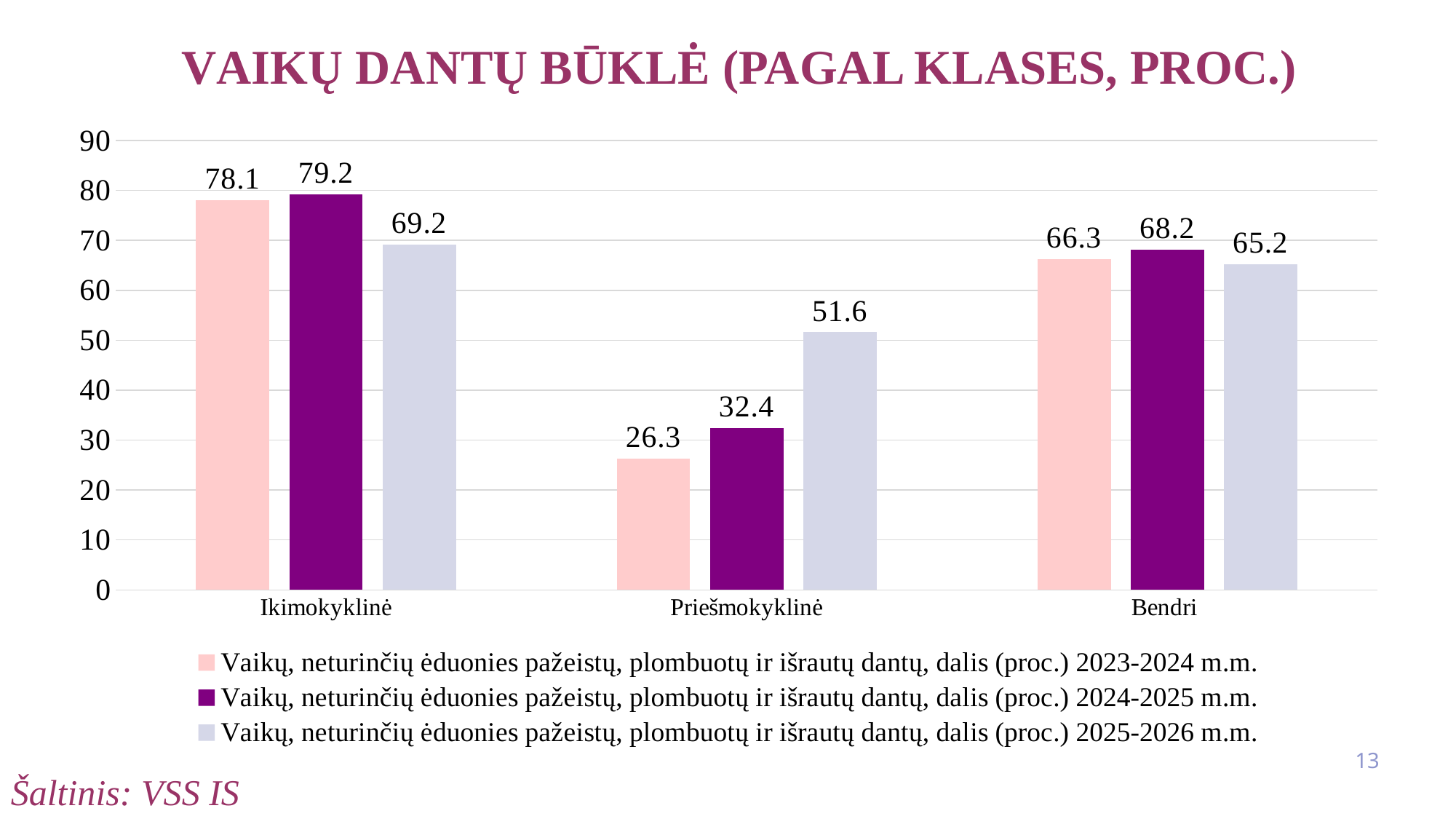
What is the value for Priešmokyklinė in the 2025-2026 m.m. series? 51.6 What is the value for Ikimokyklinė in the 2024-2025 m.m. series? 79.2 What is the difference between the 2025-2026 m.m. and 2024-2025 m.m. values for Priešmokyklinė? 19.2 Which category has the highest value in the 2025-2026 m.m. series? Ikimokyklinė What is the value for Bendri in the 2023-2024 m.m. series? 66.3 What is the title of the chart? VAIKŲ DANTŲ BŪKLĖ (PAGAL KLASES, PROC.) What kind of chart is shown on the slide? bar chart How many series does the legend list? 3 Which is larger for Bendri: the 2024-2025 m.m. value or the 2025-2026 m.m. value? 2024-2025 m.m. How many categories are shown on the x axis? 3 Which category has the lowest value in the 2023-2024 m.m. series? Priešmokyklinė Is the value for Ikimokyklinė in the 2025-2026 m.m. series greater or less than 70? less